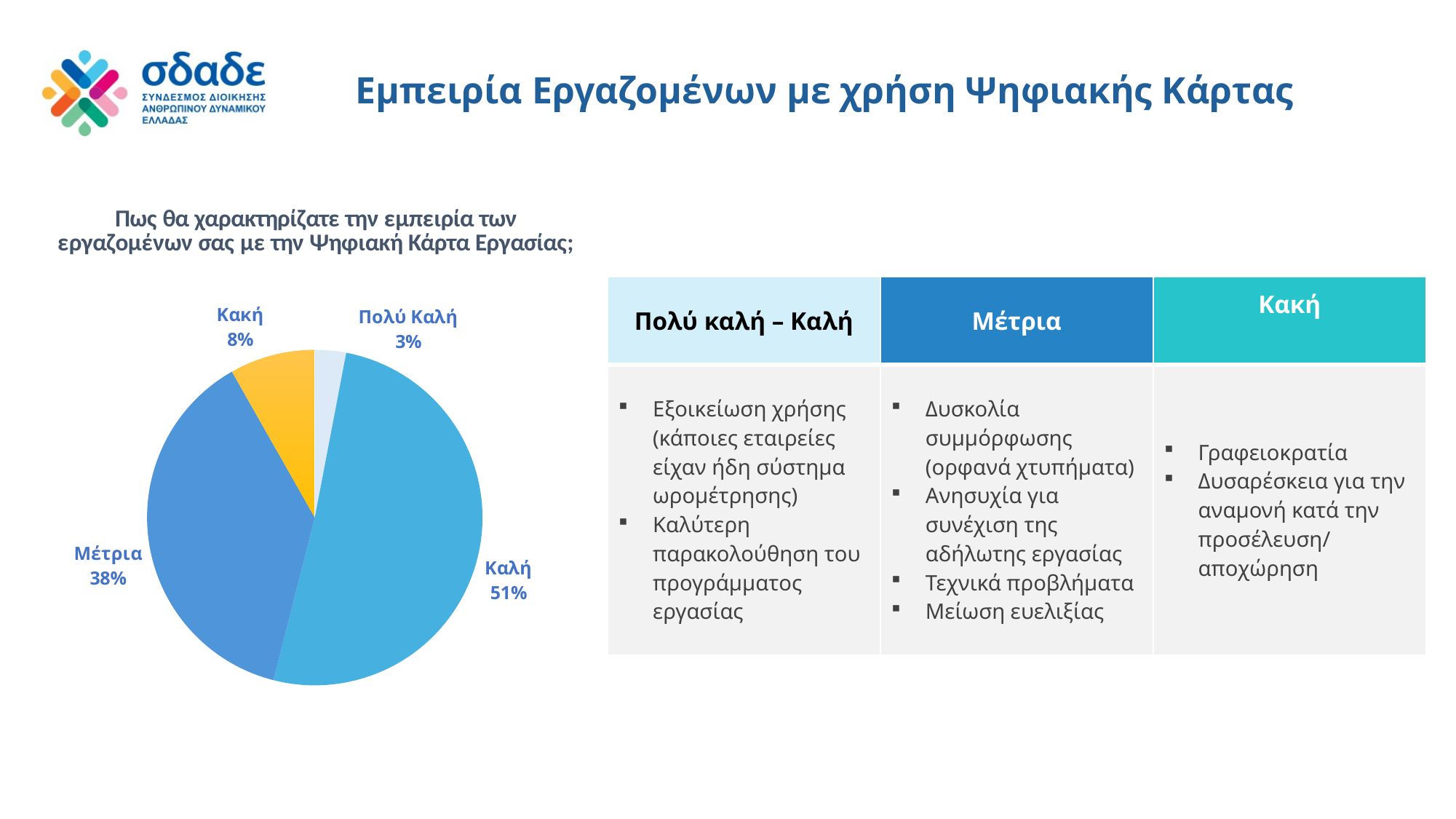
What percentage of the pie chart is labelled Καλή? 51% Which slice is larger, Κακή or Πολύ Καλή? Κακή What percentage of the pie chart is labelled Μέτρια? 38% What question is shown as the title of the pie chart? Πως θα χαρακτηρίζατε την εμπειρία των εργαζομένων σας με την Ψηφιακή Κάρτα Εργασίας; What type of chart is shown on the slide? Pie chart What percentage of the pie chart is labelled Πολύ Καλή? 3% What is the combined share of the Καλή and Πολύ Καλή slices? 54% How many slices does the pie chart have? 4 Which category has the largest slice of the pie chart? Καλή What is the difference in percentage points between the Καλή and Μέτρια slices? 13 What percentage of the pie chart is labelled Κακή? 8% Which category has the smallest slice of the pie chart? Πολύ Καλή